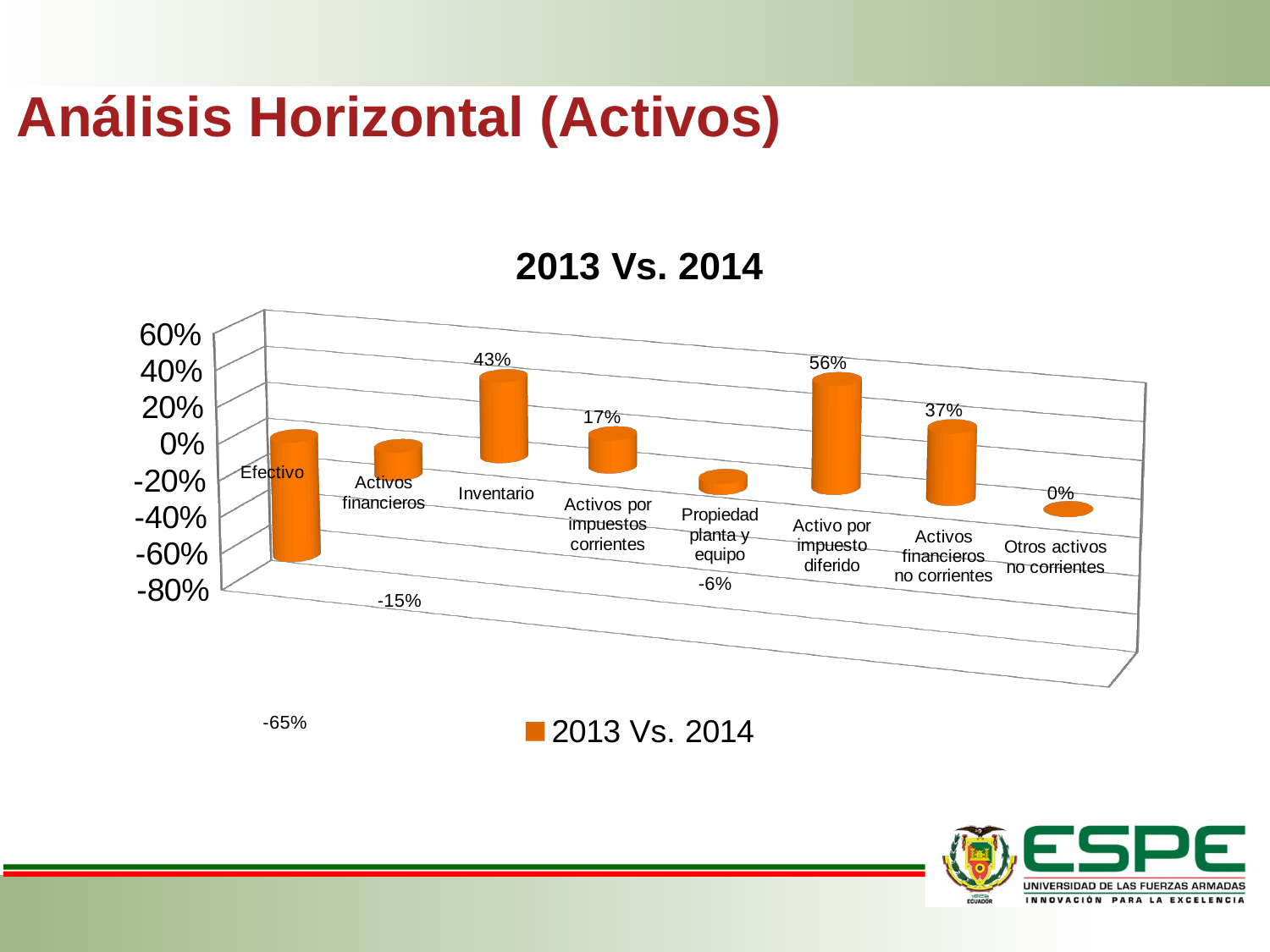
What is the difference between the values for Activo por impuesto diferido and Inventario? 13% How many categories are shown in the chart? 8 Which is larger, the value for Activos financieros no corrientes or the value for Activos por impuestos corrientes? Activos financieros no corrientes How many series does the legend list? 1 What is the value for Efectivo? -65% What is the value for Activo por impuesto diferido? 56% Which category has the highest value? Activo por impuesto diferido What is the value for Propiedad planta y equipo? -6% Is the value for Activos financieros greater or less than 0%? less What is the title of the chart? 2013 Vs. 2014 What is the value for Inventario? 43% Which category has the lowest value? Efectivo